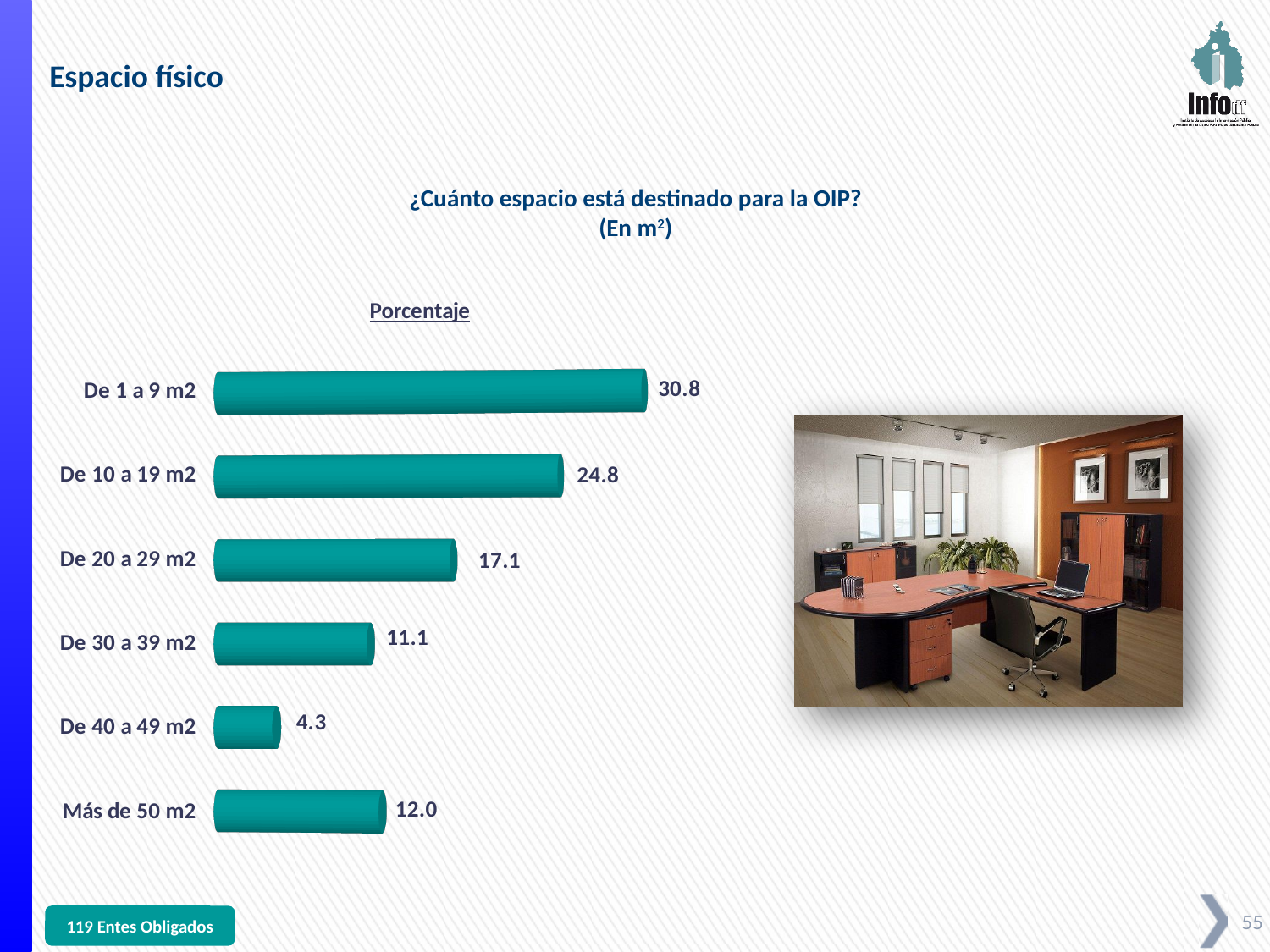
What is the difference between the values for De 1 a 9 m2 and De 10 a 19 m2? 6.0 What is the value for Más de 50 m2? 12.0 Which is larger, the value for De 30 a 39 m2 or the value for Más de 50 m2? Más de 50 m2 Which category has the lowest value? De 40 a 49 m2 What is the difference between the values for De 20 a 29 m2 and De 30 a 39 m2? 6.0 What is the value for De 1 a 9 m2? 30.8 Which category has the highest value? De 1 a 9 m2 What is the value for De 40 a 49 m2? 4.3 What is the title of the chart? Porcentaje What is the value for De 10 a 19 m2? 24.8 What kind of chart is shown on the slide? Bar chart How many categories are shown in the chart? 6